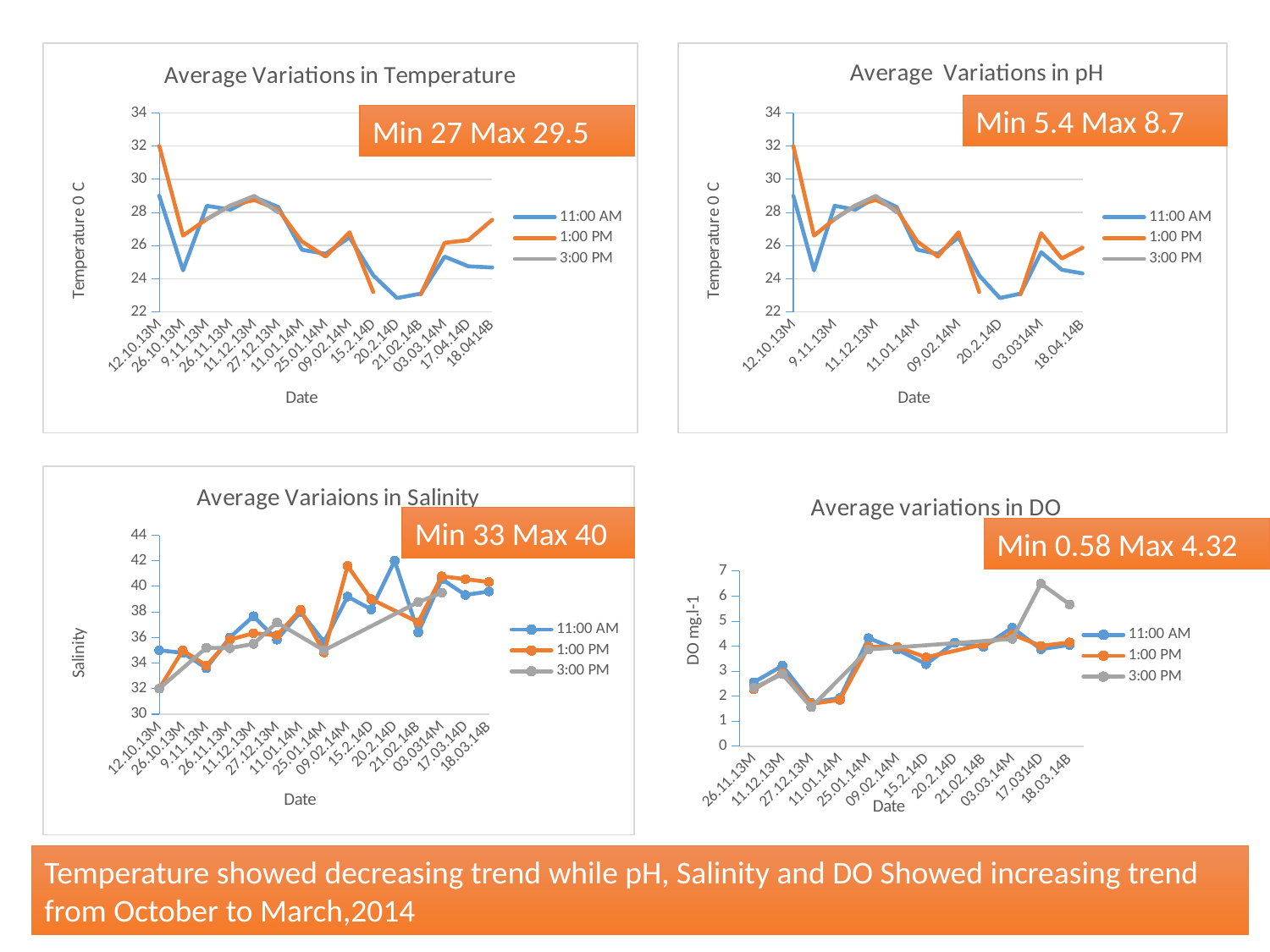
In the 'Average variations in DO' chart, do the values generally rise or fall from 26.11.13M to 18.03.14B? rise What min and max values are printed in the orange box on the 'Average Variaions in Salinity' chart? Min 33 Max 40 In the 'Average Variations in Temperature' chart, is the 1:00 PM value for 12.10.13M greater or less than 30? greater In the 'Average variations in DO' chart, how many dates are shown on the x axis? 12 In the 'Average Variations in Temperature' chart, is the 11:00 AM value for 20.2.14D greater or less than 24? less In the 'Average Variaions in Salinity' chart, at which date does the 11:00 AM series reach its highest value? 20.2.14D In the 'Average variations in DO' chart, at which date does the 3:00 PM series reach its highest value? 17.0314D In the 'Average Variaions in Salinity' chart, is the 11:00 AM value for 20.2.14D greater or less than 40? greater In the 'Average Variaions in Salinity' chart, how many dates are shown on the x axis? 15 What kind of chart is the 'Average Variations in Temperature' chart? line chart How many series does the legend of the 'Average variations in DO' chart list? 3